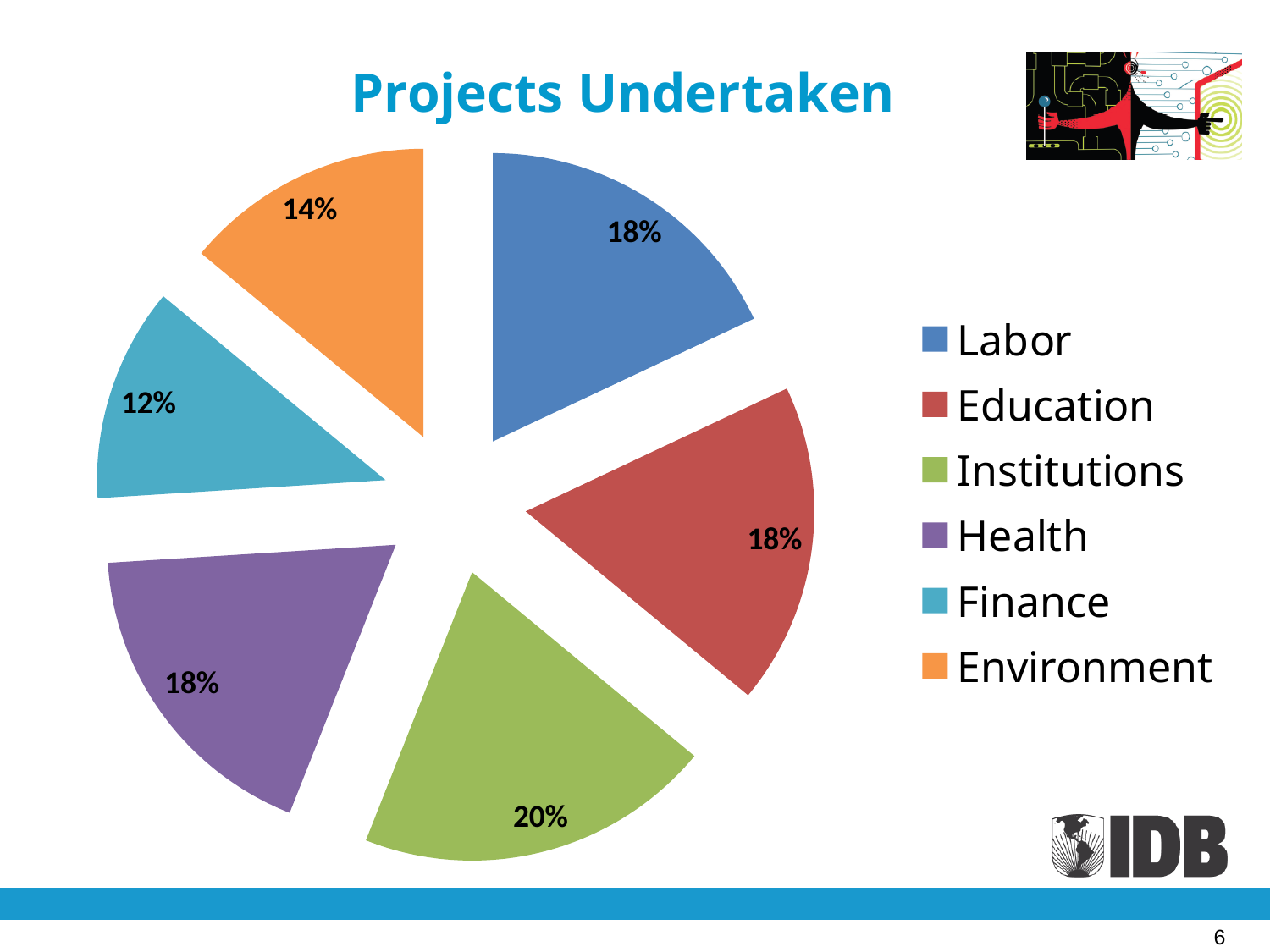
What share of projects undertaken is Labor? 18% How many categories does the pie chart show? 6 What is the title of the chart? Projects Undertaken What share of projects undertaken is Finance? 12% Which colour represents Health in the legend? Purple What type of chart is shown on the slide? Pie chart Which category has the largest share of the pie? Institutions What share of projects undertaken is Institutions? 20% What is the difference in percentage points between the Institutions share and the Finance share? 8 percentage points What share of projects undertaken is Environment? 14% Which is larger, the share for Environment or the share for Finance? Environment Which category has the smallest share of the pie? Finance